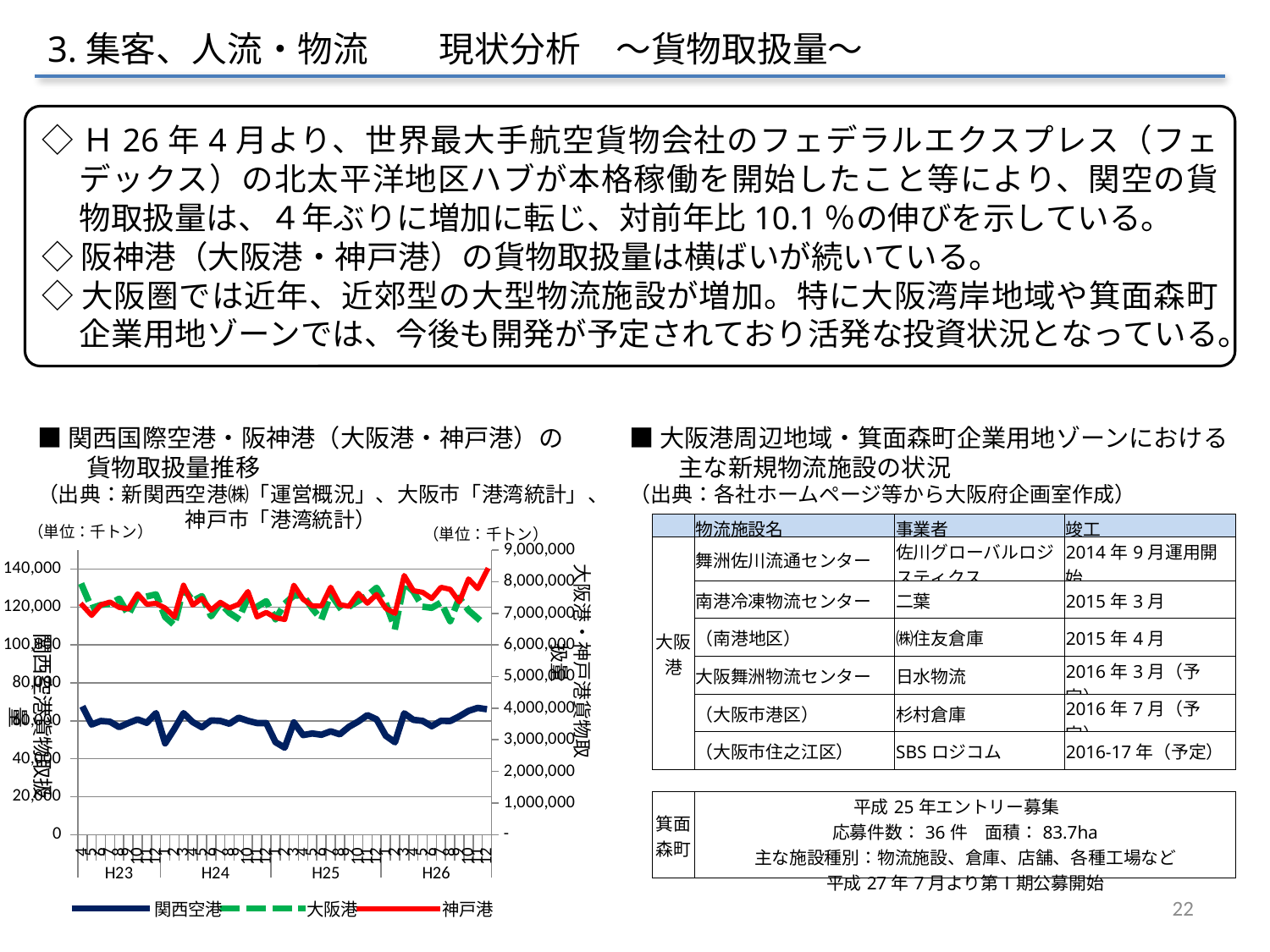
In the cargo handling volume chart, is the 関西空港 line greater or less than 20,000 on the left axis throughout the period? greater Which series is plotted lowest on the cargo handling volume chart? 関西空港 What is the highest tick value shown on the left vertical axis of the cargo handling volume chart? 140,000 How many series does the legend of the cargo handling volume chart list? 3 What is the highest tick value shown on the right vertical axis of the cargo handling volume chart? 9,000,000 How many fiscal-year groups (H23, H24, ...) are labelled along the x axis of the cargo handling volume chart? 4 In the cargo handling volume chart, does the 神戸港 line end higher or lower at the end of H26 than it starts at the beginning of H23? higher What kind of chart is used to show the cargo handling volume (貨物取扱量推移) on the slide? line chart In the cargo handling volume chart, is the 関西空港 line greater or less than 80,000 on the left axis throughout the period? less In the cargo handling volume chart, is the 大阪港 line greater or less than 9,000,000 on the right axis throughout the period? less What are the three series named in the legend of the cargo handling volume chart? 関西空港, 大阪港, 神戸港